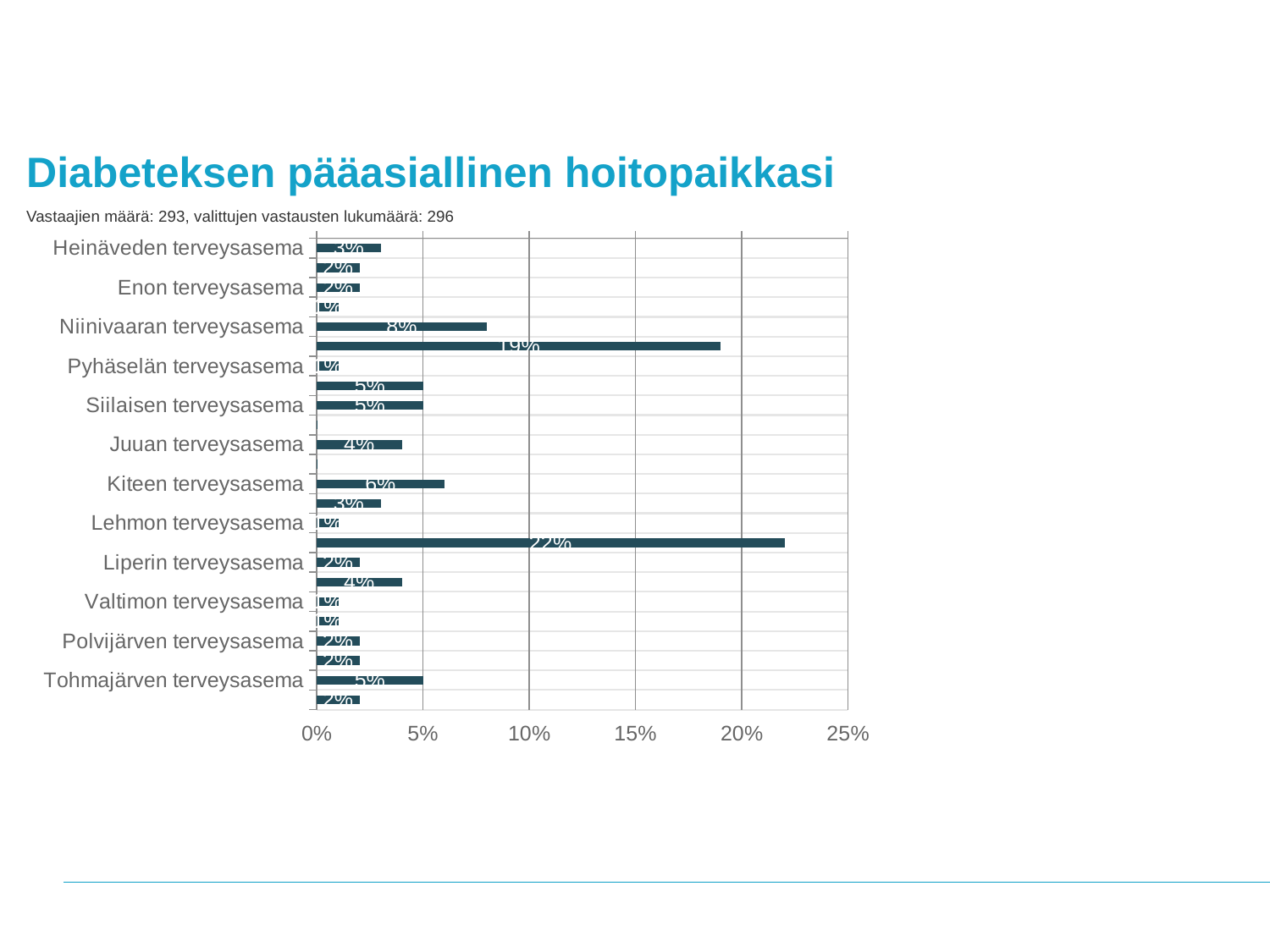
What is the difference between the values for Niinivaaran terveysasema and Kiteen terveysasema? 2% What is the value for Juuan terveysasema? 4% Is the value for Juuan terveysasema greater or less than 5%? less What is the value for Tohmajärven terveysasema? 5% What is the value for Kiteen terveysasema? 6% What is the value for Niinivaaran terveysasema? 8% Is the value for Niinivaaran terveysasema greater or less than 5%? greater Which is larger, the value for Niinivaaran terveysasema or the value for Kiteen terveysasema? Niinivaaran terveysasema Which is larger, the value for Kiteen terveysasema or the value for Juuan terveysasema? Kiteen terveysasema What kind of chart is shown on the slide? bar chart What is the value for Siilaisen terveysasema? 5% What is the title of the chart? Diabeteksen pääasiallinen hoitopaikkasi